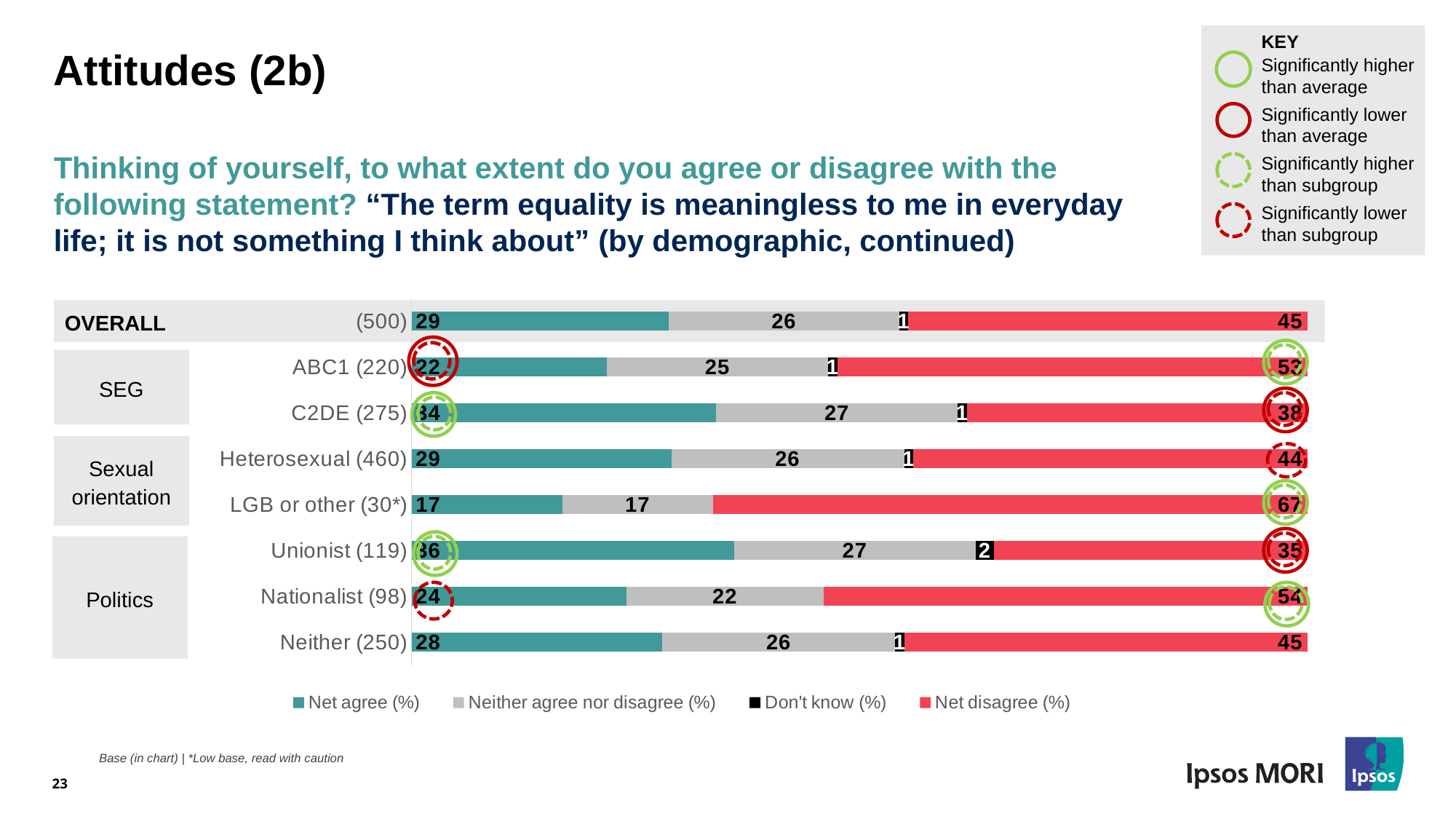
Which demographic group has the highest Net disagree (%) value? LGB or other (30*) Which is larger: the Net agree (%) value for Neither (250) or for Nationalist (98)? Neither (250) What is the Net agree (%) value for OVERALL (500)? 29 How many series does the chart legend list? 4 Which demographic group has the lowest Net agree (%) value? LGB or other (30*) What is the Net disagree (%) value for Heterosexual (460)? 44 How many demographic groups (bars) are shown in the chart, including OVERALL? 8 What is the Net agree (%) value for LGB or other (30*)? 17 What is the Don't know (%) value for Unionist (119)? 2 What is the total of the stacked bar for Neither (250)? 100 What is the Neither agree nor disagree (%) value for Unionist (119)? 27 What is the difference between the Net disagree (%) and Net agree (%) values for OVERALL (500)? 16